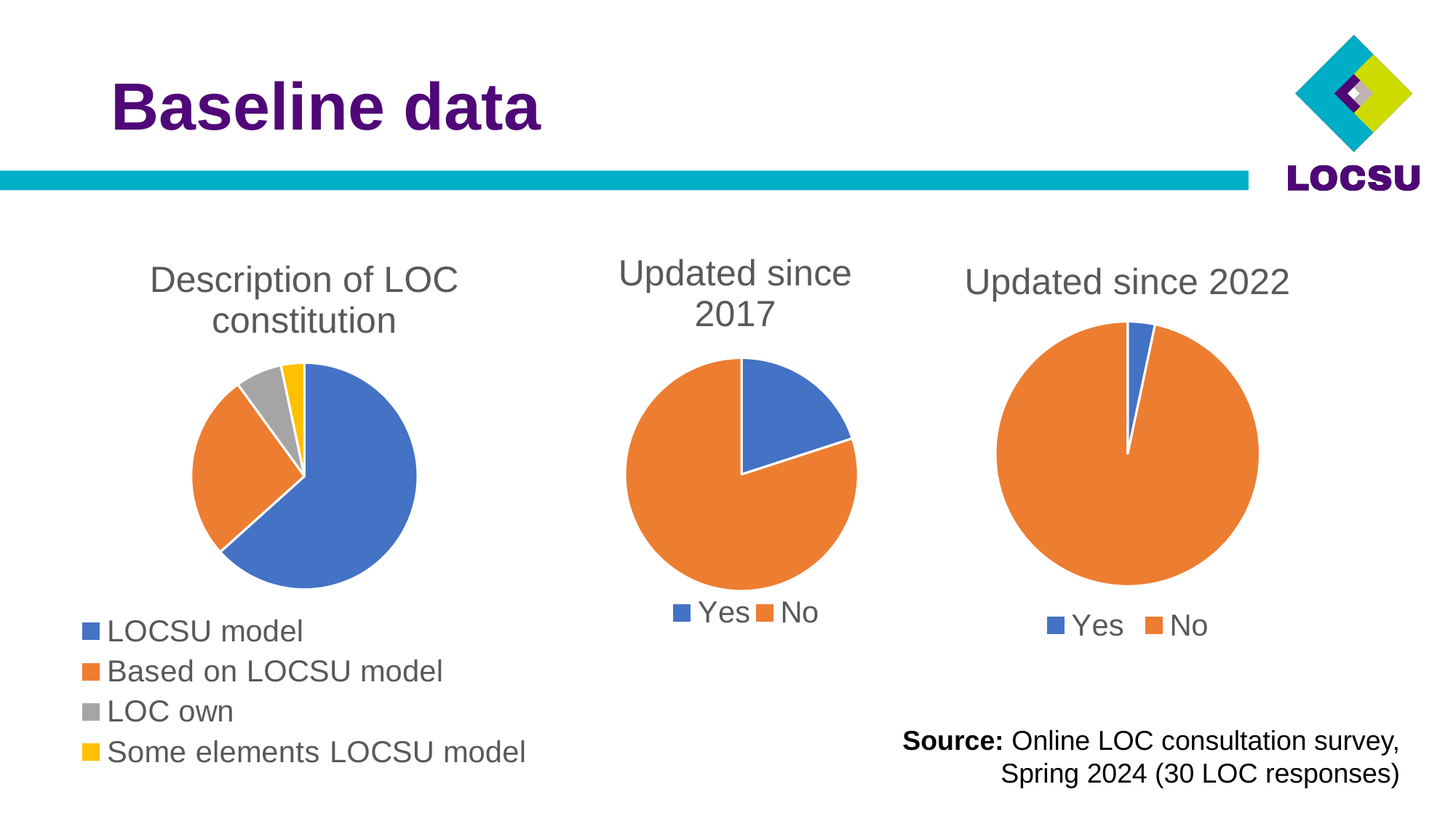
In the "Description of LOC constitution" chart, which slice is larger: "Based on LOCSU model" or "LOC own"? Based on LOCSU model What kind of chart is "Description of LOC constitution"? Pie chart What are the legend entries of the "Updated since 2022" chart? Yes, No How many categories does the "Description of LOC constitution" pie chart show? 4 In the "Updated since 2017" chart, which response has the larger slice? No In the "Updated since 2022" chart, which response has the smaller slice? Yes What kind of chart is "Updated since 2022"? Pie chart In the "Description of LOC constitution" chart, what colour is the "LOC own" slice? Grey How many categories does the "Updated since 2017" pie chart show? 2 Which chart has the larger "Yes" slice: "Updated since 2017" or "Updated since 2022"? Updated since 2017 In the "Description of LOC constitution" chart, which category has the largest slice? LOCSU model In the "Description of LOC constitution" chart, which category has the smallest slice? Some elements LOCSU model